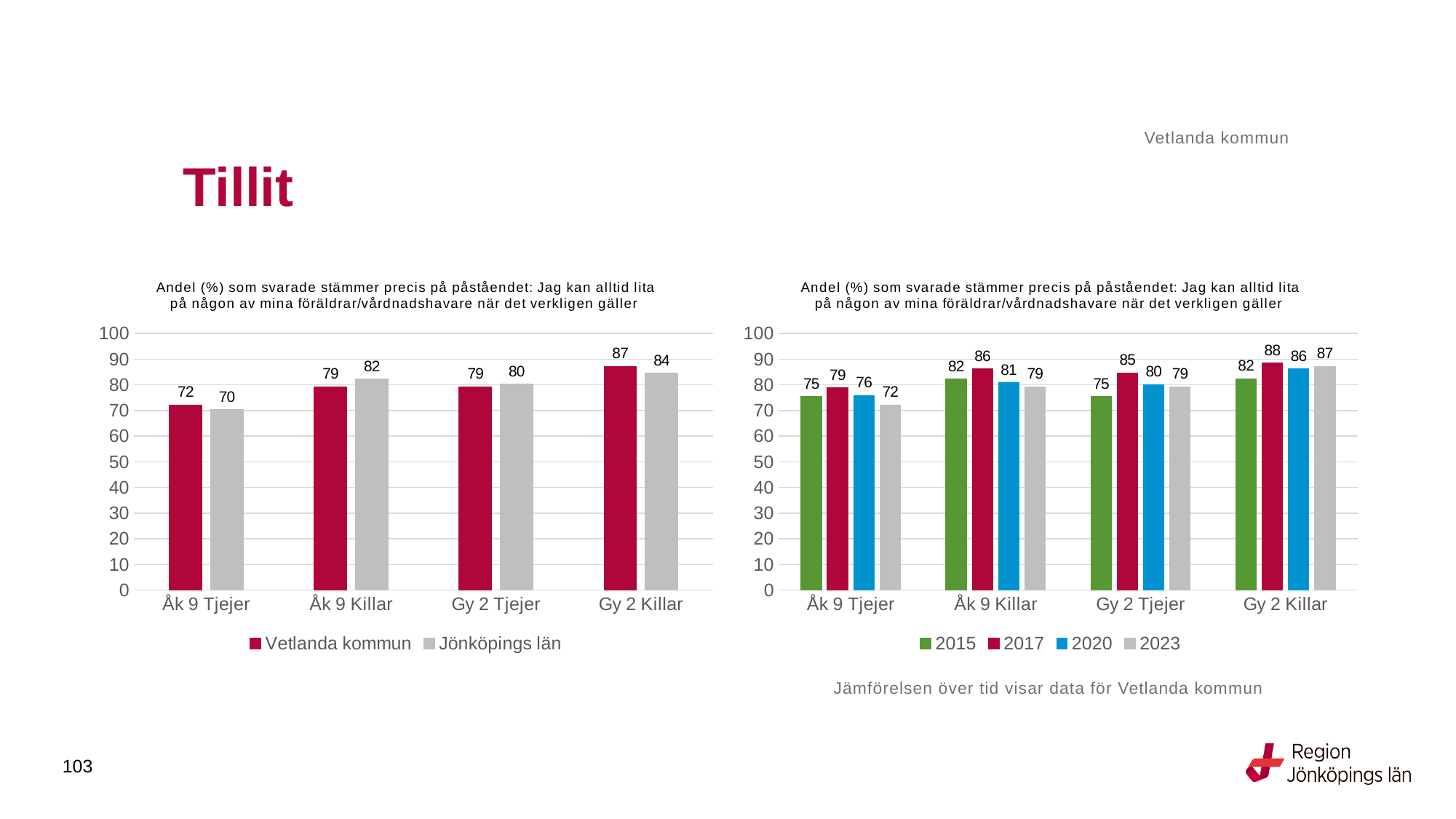
In the right chart, what is the value for 2017 for Gy 2 Killar? 88 In the left chart, which category has the lowest value for Jönköpings län? Åk 9 Tjejer In the left chart, which category has the highest value for Vetlanda kommun? Gy 2 Killar In the right chart, what is the value for 2023 for Åk 9 Tjejer? 72 What kind of chart is the right chart? Bar chart In the left chart, what is the value for Jönköpings län for Gy 2 Killar? 84 In the left chart, what is the difference between Vetlanda kommun and Jönköpings län for Åk 9 Killar? 3 In the left chart, how many series does the legend list? 2 In the right chart, how many series does the legend list? 4 In the right chart, how many categories are shown on the x axis? 4 In the right chart, which is larger for Gy 2 Tjejer: the value for 2015 or the value for 2017? 2017 In the left chart, what is the value for Vetlanda kommun for Åk 9 Tjejer? 72